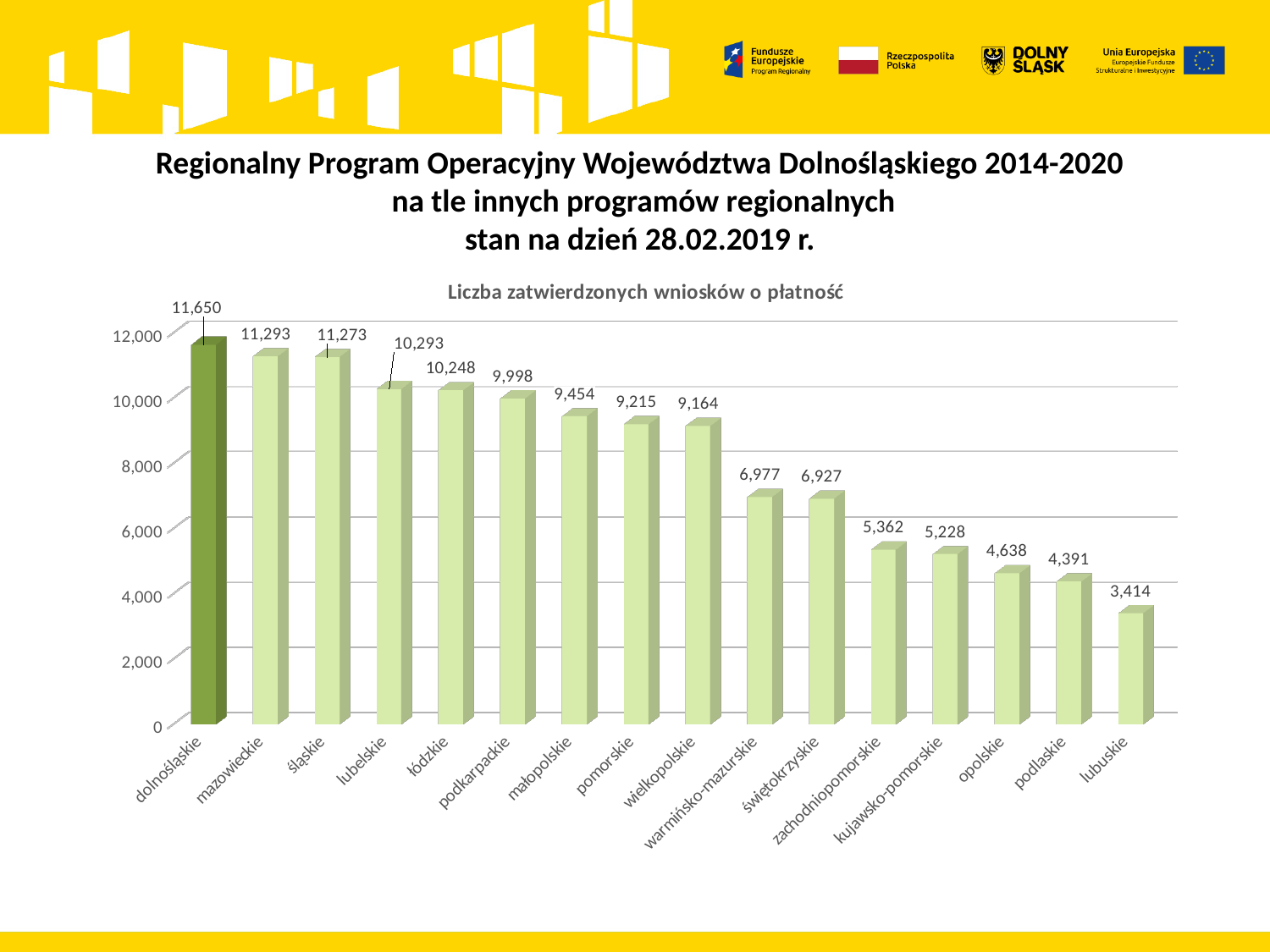
What is the title of the chart? Liczba zatwierdzonych wniosków o płatność What is the difference between the values for dolnośląskie and mazowieckie? 357 What is the value for zachodniopomorskie? 5,362 Which is larger, the value for małopolskie or the value for warmińsko-mazurskie? małopolskie What is the difference between the values for opolskie and podlaskie? 247 How many categories are shown on the x axis? 16 What kind of chart is this? bar chart What is the value for dolnośląskie? 11,650 What is the value for lubuskie? 3,414 Which category has the highest value? dolnośląskie What is the value for podkarpackie? 9,998 Which category has the lowest value? lubuskie